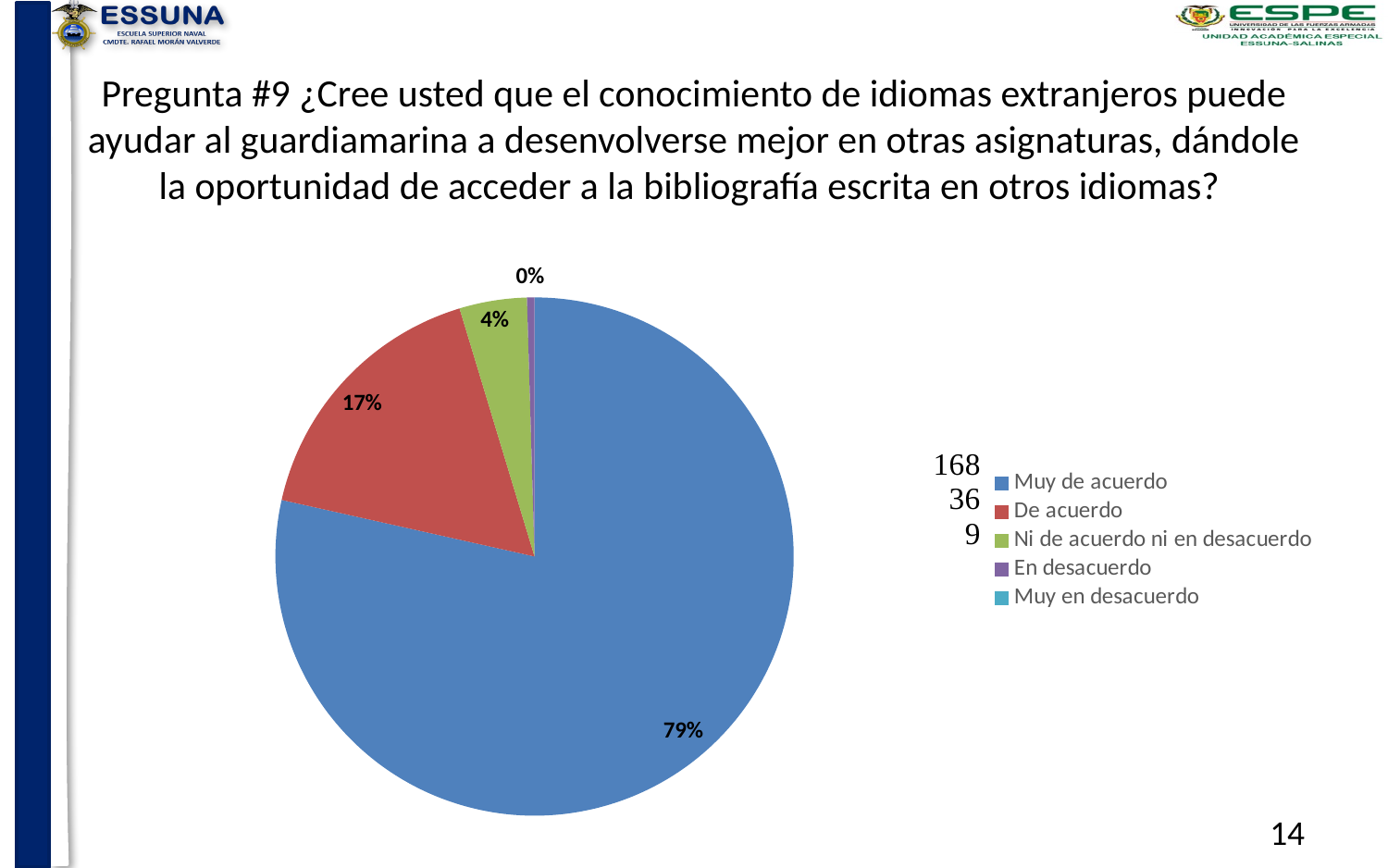
How many entries does the legend list? 5 What is the difference in percentage points between "Muy de acuerdo" and "De acuerdo"? 62% Which is larger, the share for "De acuerdo" or the share for "Ni de acuerdo ni en desacuerdo"? De acuerdo What is the difference in percentage points between "De acuerdo" and "Ni de acuerdo ni en desacuerdo"? 13% What percentage of the pie corresponds to "De acuerdo"? 17% What kind of chart is shown on the slide? pie chart What percentage label is shown for the "En desacuerdo" slice? 0% What percentage of the pie corresponds to "Muy de acuerdo"? 79% What colour is the "De acuerdo" slice? red What percentage of the pie corresponds to "Ni de acuerdo ni en desacuerdo"? 4% Which category has the largest share of the pie? Muy de acuerdo What colour is the "Muy de acuerdo" slice? blue